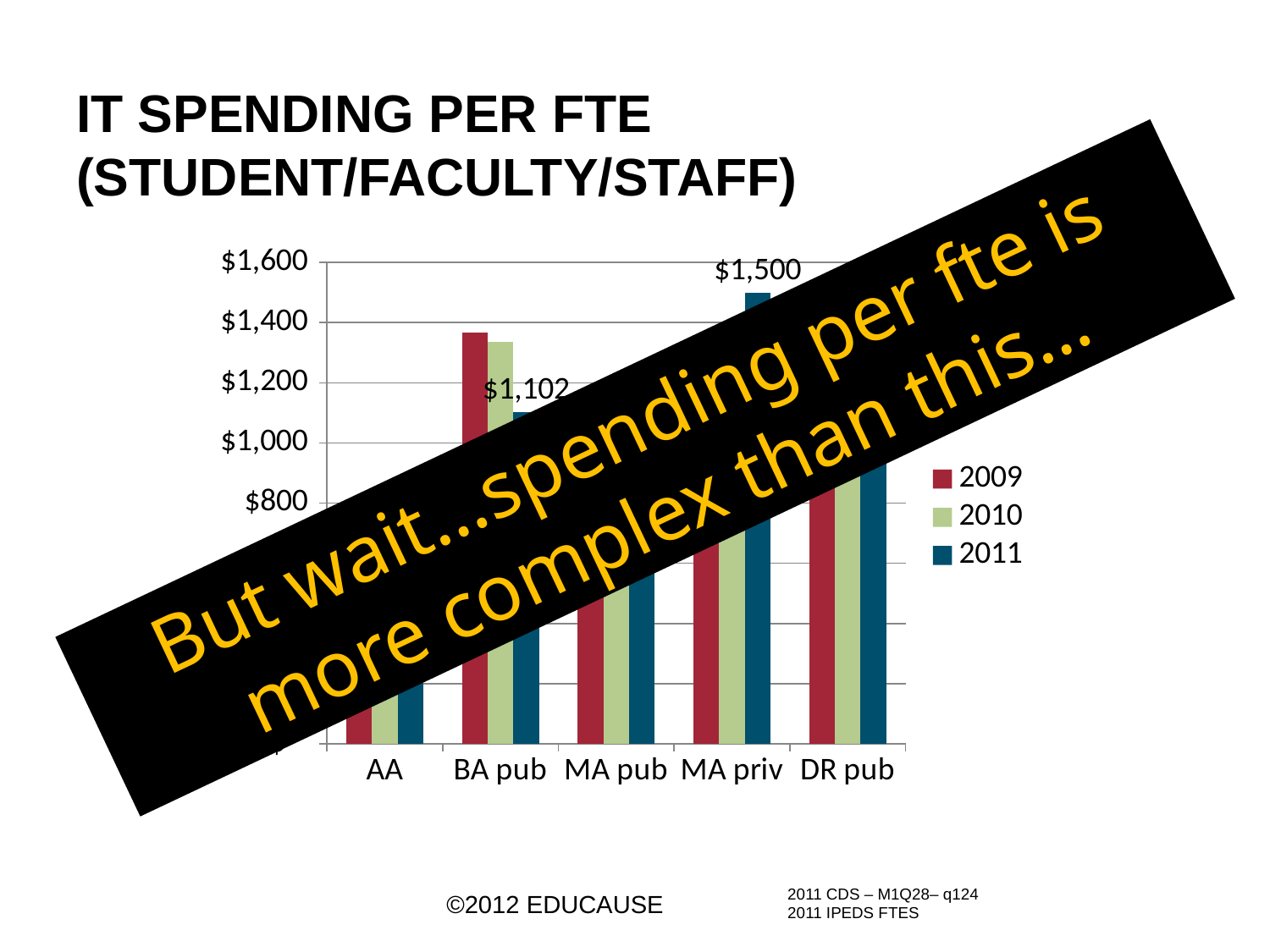
How many categories are shown on the x axis? 5 Which years are listed in the legend? 2009, 2010, 2011 Is the 2011 value for MA priv greater or less than $1,400? greater What kind of chart is shown on the slide? bar chart For BA pub, which is larger, the 2009 value or the 2011 value? 2009 What is the difference between the 2011 values for MA priv and BA pub? $398 What is the 2011 IT spending per FTE for BA pub? $1,102 What is the 2011 IT spending per FTE for MA priv? $1,500 What is the title of the chart? IT SPENDING PER FTE (STUDENT/FACULTY/STAFF) How many series does the legend list? 3 Is the 2009 value for BA pub greater or less than $1,200? greater Which has the larger 2011 value, MA priv or BA pub? MA priv